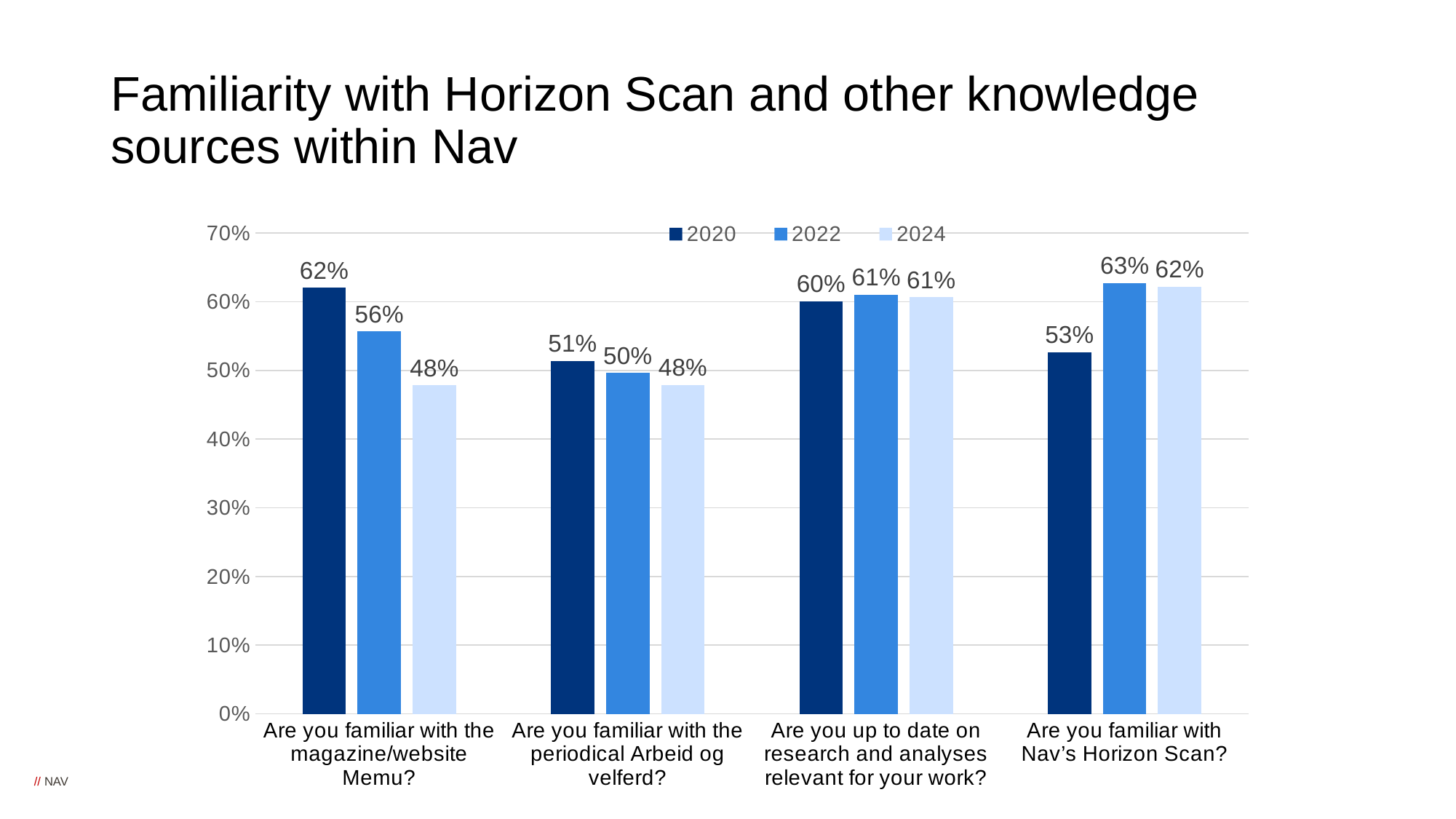
Do the values for "Are you familiar with the periodical Arbeid og velferd?" rise or fall from 2020 to 2024? Fall How many question categories are shown on the x axis? 4 How many series does the legend list? 3 Which is larger: the 2020 value for "Are you familiar with Nav's Horizon Scan?" or the 2020 value for "Are you familiar with the magazine/website Memu?"? Are you familiar with the magazine/website Memu? What is the 2022 value for "Are you familiar with Nav's Horizon Scan?"? 63% What is the difference between the 2020 and 2024 values for "Are you familiar with the magazine/website Memu?"? 14 percentage points What is the 2020 value for "Are you up to date on research and analyses relevant for your work?"? 60% What is the 2020 value for "Are you familiar with the magazine/website Memu?"? 62% Which year has the highest value for "Are you familiar with Nav's Horizon Scan?"? 2022 Which year has the lowest value for "Are you familiar with the magazine/website Memu?"? 2024 What is the 2024 value for "Are you familiar with the periodical Arbeid og velferd?"? 48% What kind of chart is shown on the slide? Bar chart